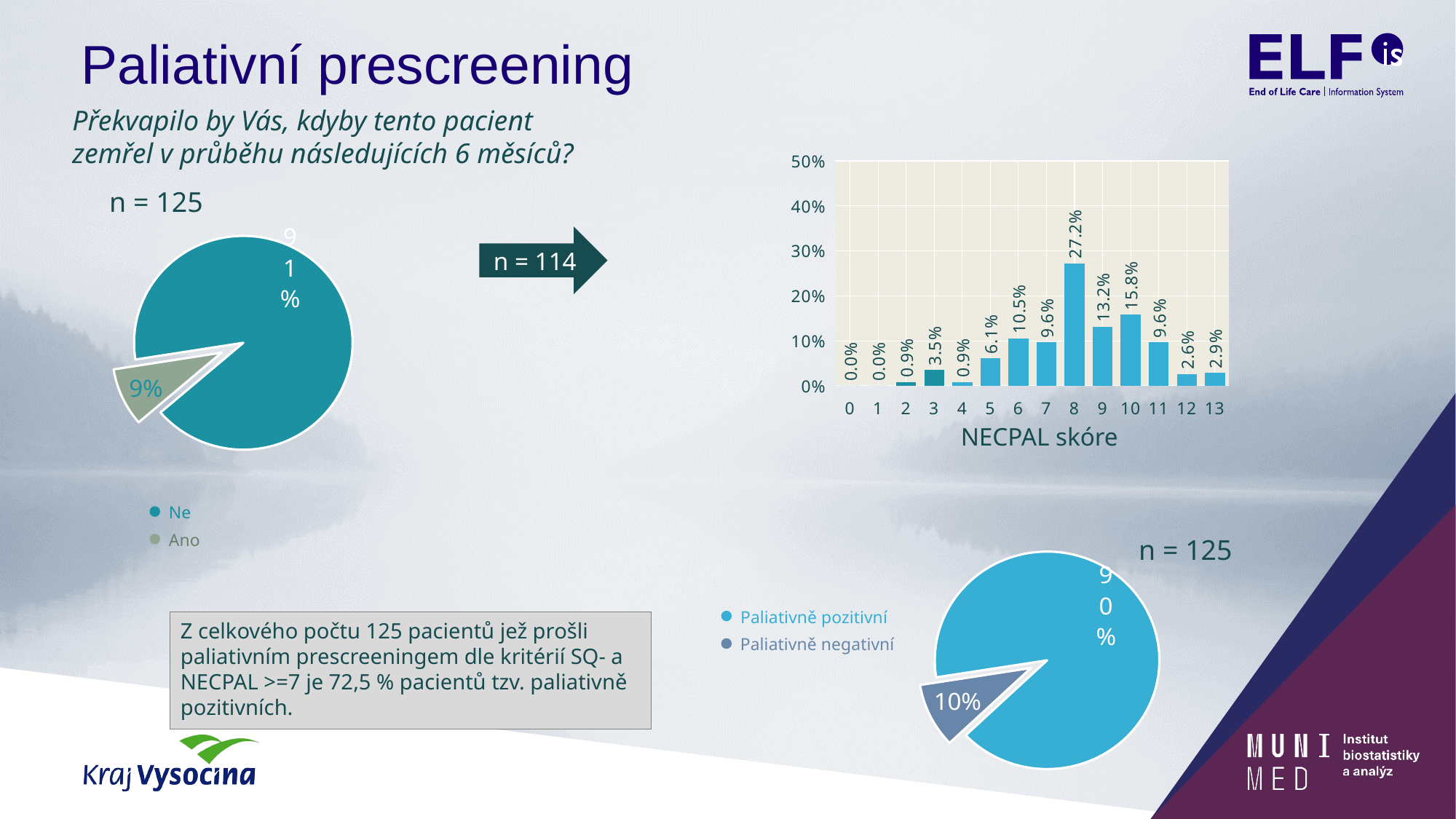
In the NECPAL skóre bar chart, which is larger, the value for score 6 or the value for score 11? score 6 In the NECPAL skóre bar chart, is the value for score 8 greater or less than 20%? greater In the NECPAL skóre bar chart, what is the difference between the values for score 8 and score 9? 14.0% In the NECPAL skóre bar chart, what is the value for score 10? 15.8% In the NECPAL skóre bar chart, which score has the highest value? 8 In the NECPAL skóre bar chart, what is the value for score 8? 27.2% In the pie chart at the bottom right, what share does the 'Paliativně negativní' slice have? 10% How many score categories are shown on the x axis of the NECPAL skóre bar chart? 14 In the pie chart on the left (n = 125), what share does the 'Ne' slice have? 91% What kind of chart is the NECPAL skóre chart? bar chart How many entries does the legend of the bottom-right pie chart list? 2 In the pie chart on the left (n = 125), what share does the 'Ano' slice have? 9%